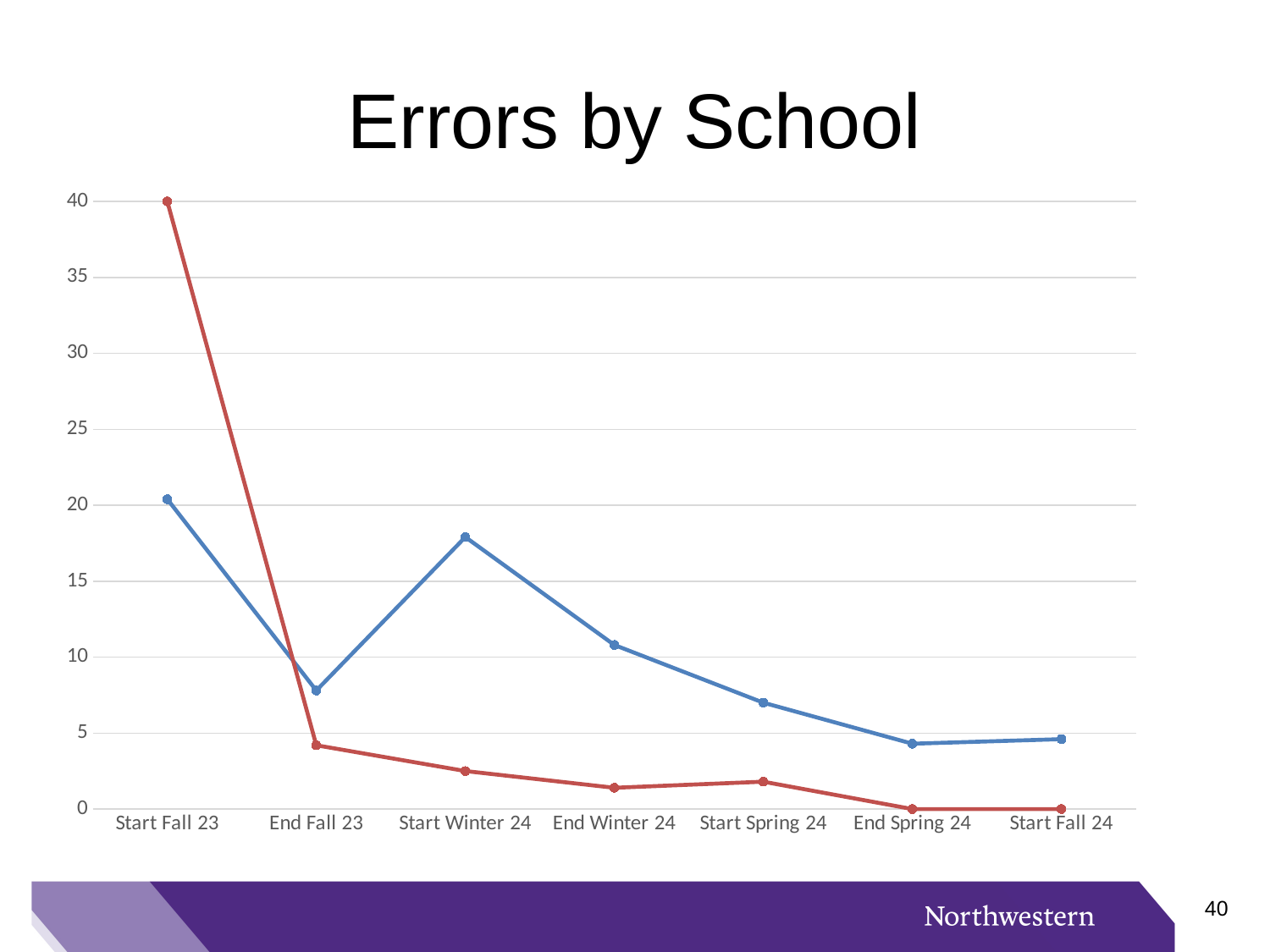
What is the title of the chart? Errors by School At which category does the red line reach its highest value? Start Fall 23 Is the value of the red line at End Fall 23 greater or less than 5? less How many lines are plotted on the chart? 2 How many categories are shown along the x axis? 7 What kind of chart is shown on the slide? line chart Is the value of the blue line at Start Winter 24 greater or less than 15? greater What is the value of the red line at Start Fall 23? 40 At which category does the blue line reach its lowest value? End Spring 24 Does the red line generally rise or fall from Start Fall 23 to Start Fall 24? fall At Start Winter 24, which line has the higher value, the red line or the blue line? the blue line What is the value of the red line at End Spring 24? 0